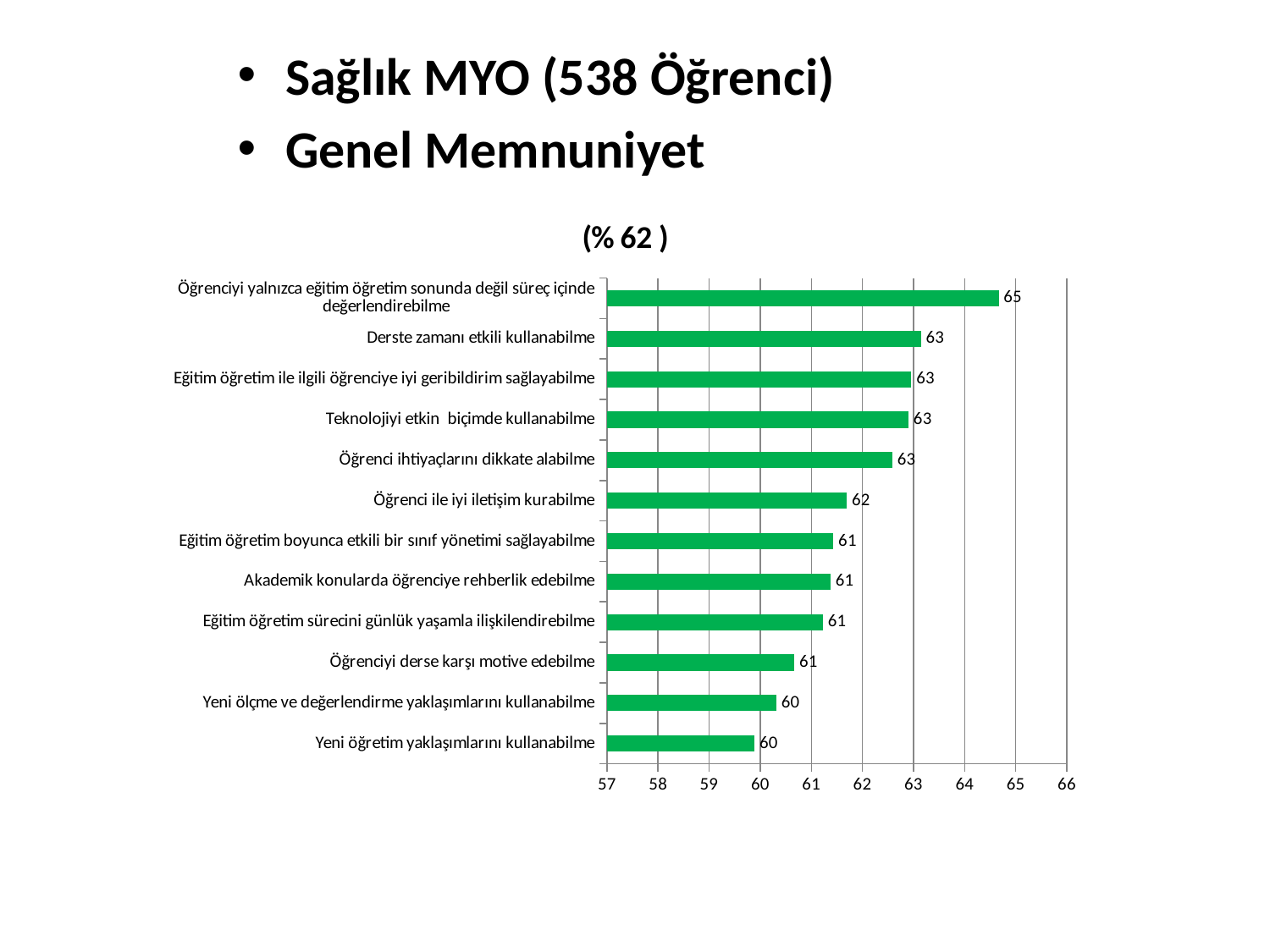
What is the title shown above the chart? (% 62 ) Is the value for "Yeni ölçme ve değerlendirme yaklaşımlarını kullanabilme" greater or less than 61? less What is the value for "Derste zamanı etkili kullanabilme"? 63 How many categories are plotted in the chart? 12 What is the value for "Yeni öğretim yaklaşımlarını kullanabilme"? 60 Which is larger: the value for "Derste zamanı etkili kullanabilme" or the value for "Öğrenciyi derse karşı motive edebilme"? Derste zamanı etkili kullanabilme What is the difference between the value for "Öğrenciyi yalnızca eğitim öğretim sonunda değil süreç içinde değerlendirebilme" and the value for "Yeni öğretim yaklaşımlarını kullanabilme"? 5 Which category has the highest value? Öğrenciyi yalnızca eğitim öğretim sonunda değil süreç içinde değerlendirebilme What colour are the bars in the chart? green What is the value for "Öğrenci ile iyi iletişim kurabilme"? 62 What is the value for "Öğrenciyi derse karşı motive edebilme"? 61 What kind of chart is shown on the slide? bar chart